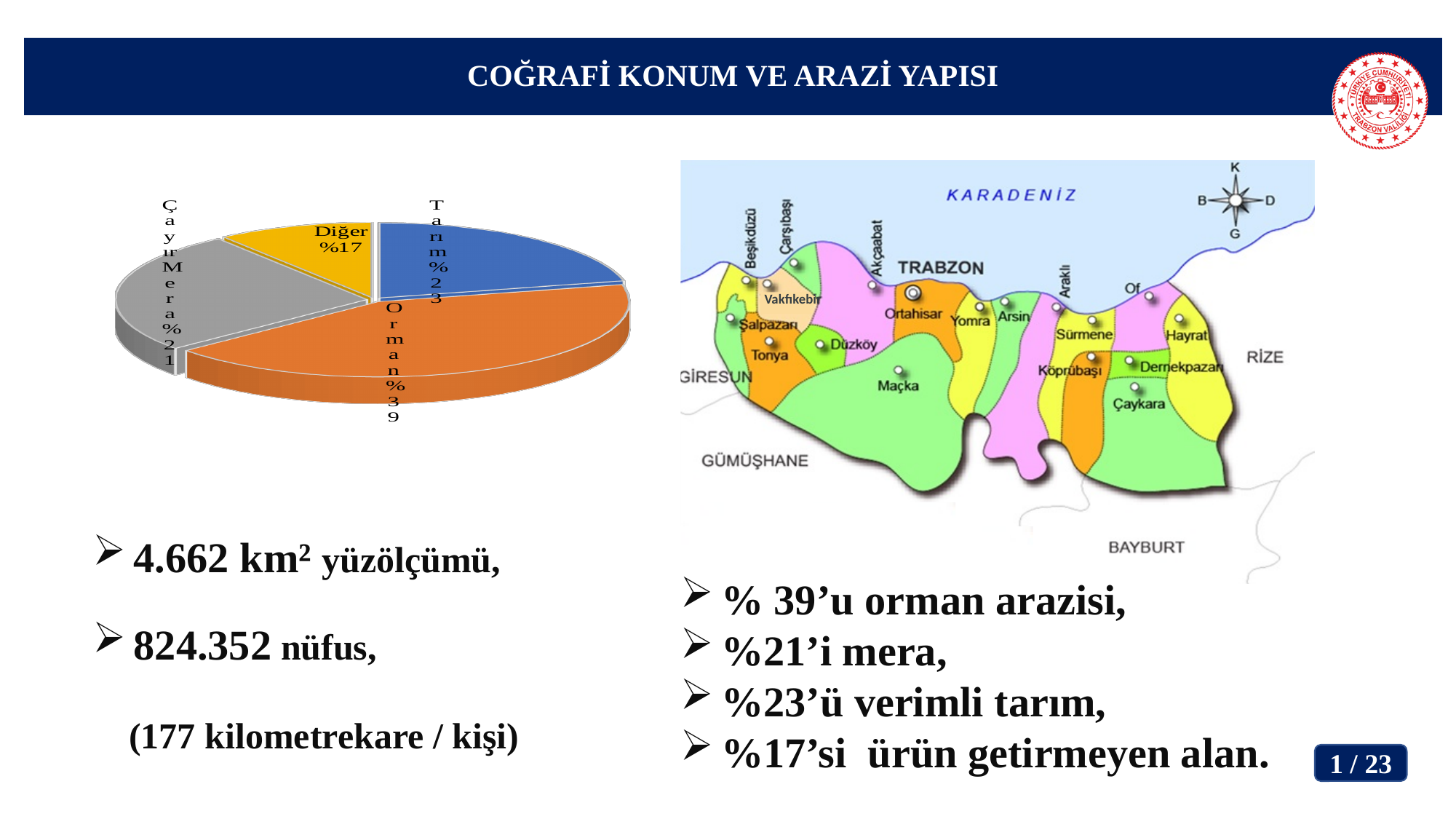
What percentage does the Tarım slice of the pie chart represent? %23 How many slices does the pie chart have? 4 What percentage does the Çayır Mera slice of the pie chart represent? %21 What colour is the Orman slice in the pie chart? Orange What percentage does the Diğer slice of the pie chart represent? %17 Which slice of the pie chart is the smallest? Diğer What is the difference in percentage points between the Orman and Tarım slices? 16 What kind of chart is shown on the left of the slide? Pie chart Which slice of the pie chart is the largest? Orman What percentage does the Orman slice of the pie chart represent? %39 What is the combined share of the Tarım and Orman slices? %62